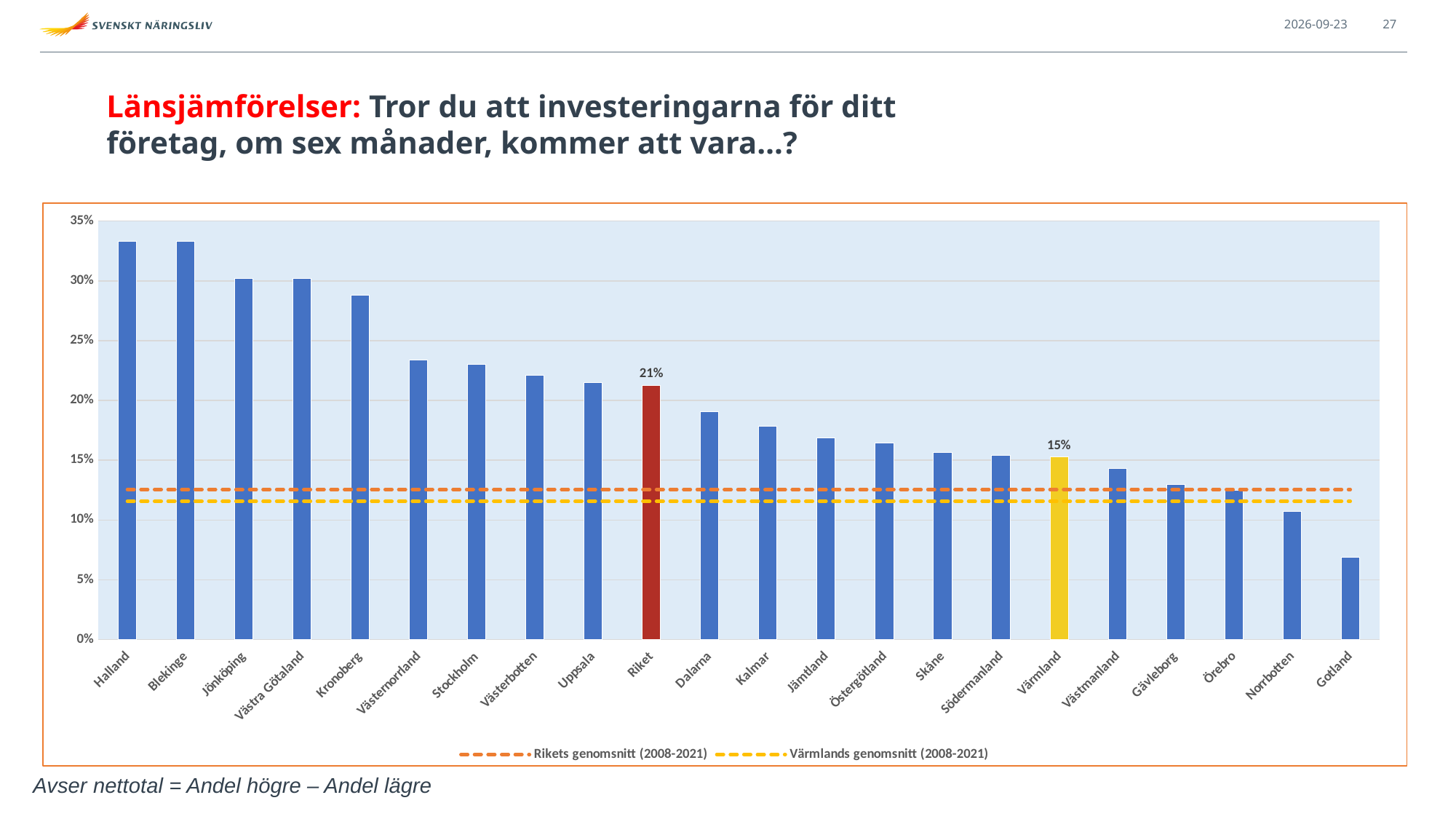
Is the value for Stockholm greater or less than 20%? greater What kind of chart is shown on the slide? Bar chart Which county has the lowest value in the chart? Gotland Do the bar values rise or fall from left to right along the x axis? Fall How many entries does the chart legend list? 2 What is the difference between the values for Riket and Värmland? 6% Which is larger, the value for Riket or the value for Värmland? Riket What value is shown for Värmland? 15% Is the value for Halland greater or less than 30%? greater What value is shown for Riket? 21% Is the value for Gotland greater or less than 10%? less How many bars (categories) are shown in the chart? 22